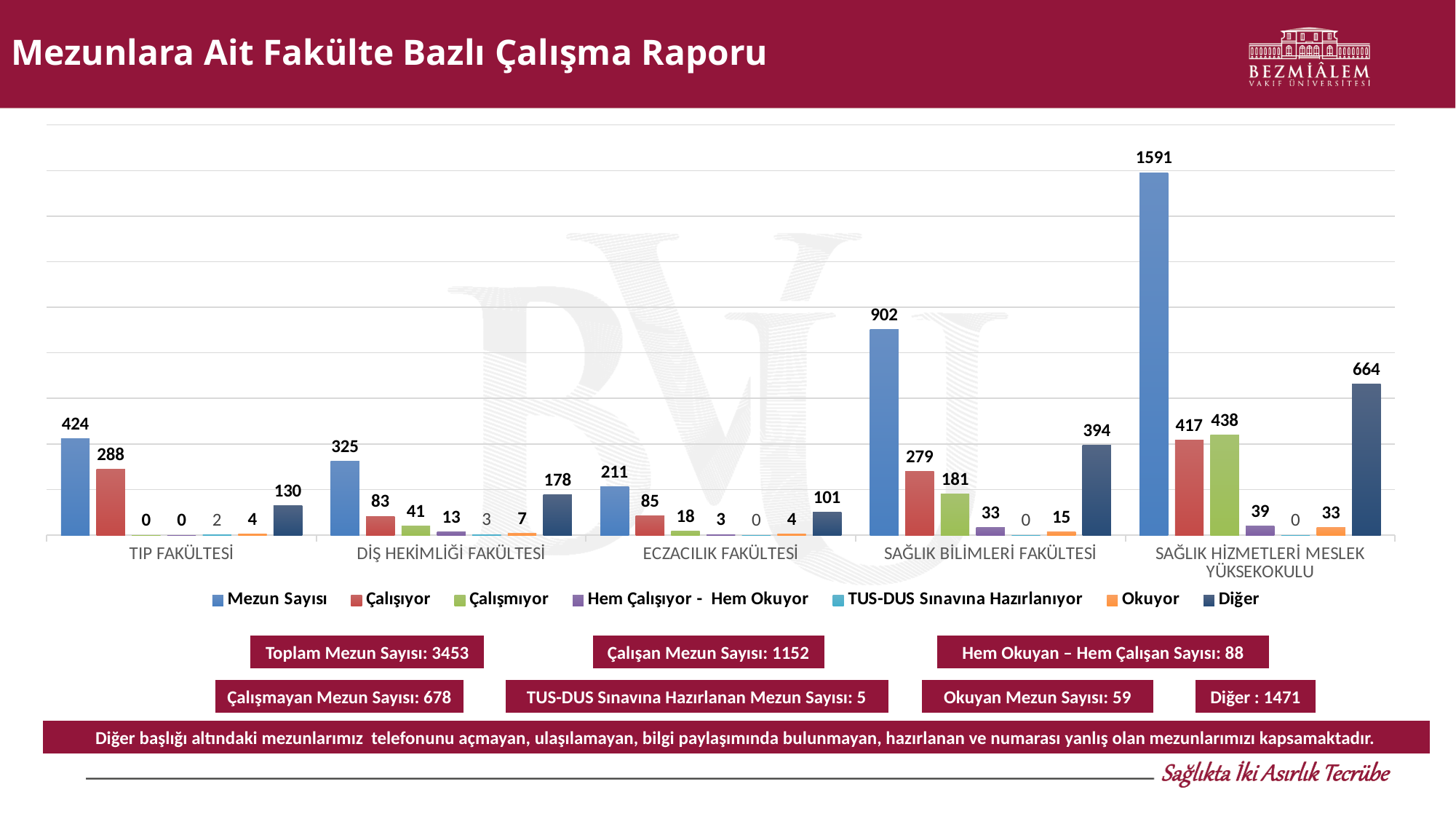
What is the difference between the Mezun Sayısı values for SAĞLIK BİLİMLERİ FAKÜLTESİ and TIP FAKÜLTESİ? 478 How many series does the legend list? 7 Which is larger for SAĞLIK HİZMETLERİ MESLEK YÜKSEKOKULU: Çalışıyor or Çalışmıyor? Çalışmıyor What is the Çalışmıyor value for DİŞ HEKİMLİĞİ FAKÜLTESİ? 41 How many faculty categories are shown on the x axis? 5 Which faculty has the lowest Mezun Sayısı? ECZACILIK FAKÜLTESİ What is the Diğer value for SAĞLIK BİLİMLERİ FAKÜLTESİ? 394 What is the Çalışıyor value for TIP FAKÜLTESİ? 288 What is the Mezun Sayısı value for SAĞLIK HİZMETLERİ MESLEK YÜKSEKOKULU? 1591 What type of chart is shown on the slide? bar chart What is the title of the slide containing the chart? Mezunlara Ait Fakülte Bazlı Çalışma Raporu Which faculty has the highest Mezun Sayısı? SAĞLIK HİZMETLERİ MESLEK YÜKSEKOKULU